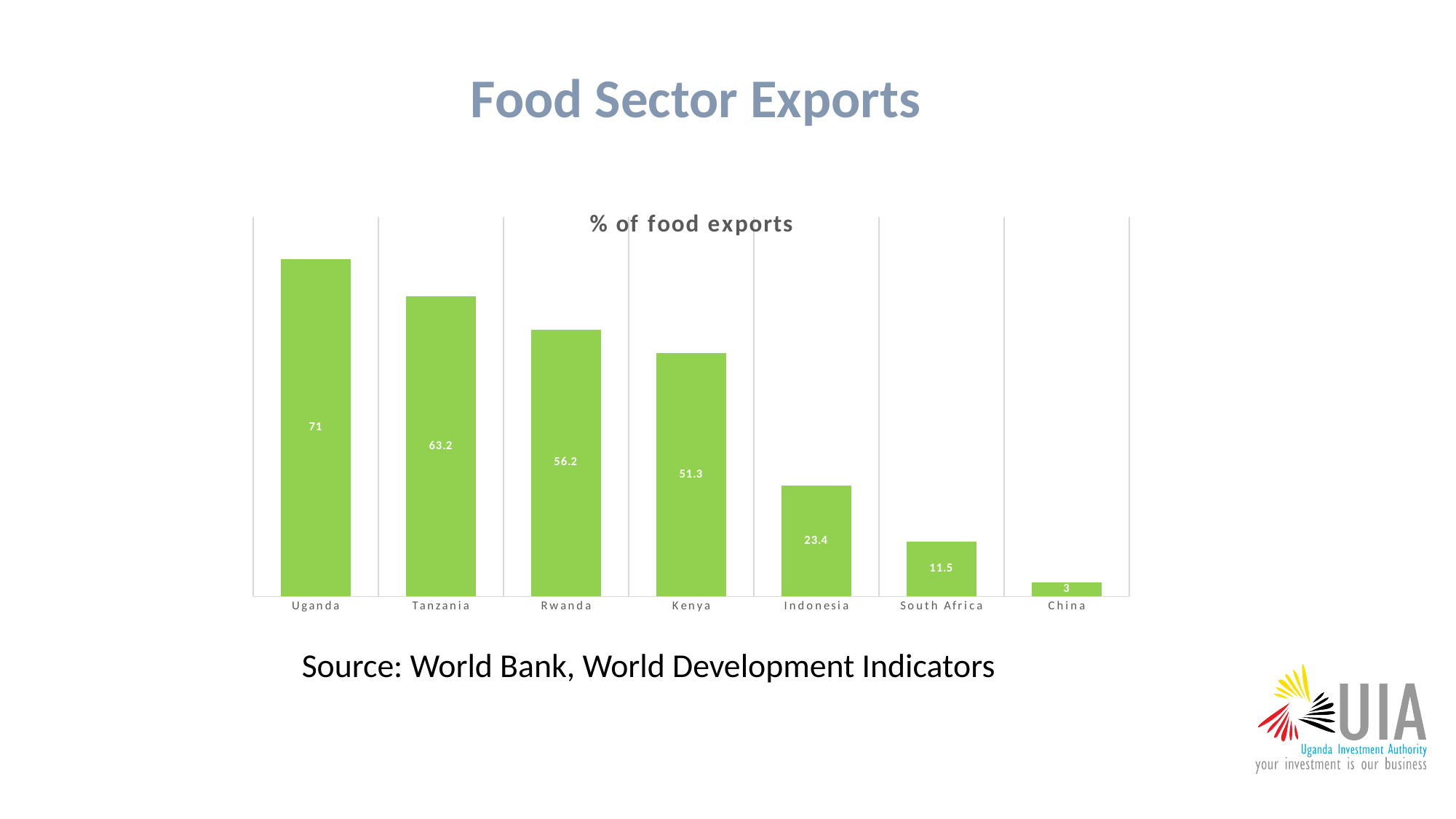
What kind of chart is shown on the slide? Bar chart Do the values rise or fall from left to right across the countries? Fall What is the difference between the values for Indonesia and China? 20.4 What is the value for South Africa? 11.5 Which country has the lowest value? China What is the value for Kenya? 51.3 Which country has the highest value? Uganda What is the difference between the values for Uganda and Tanzania? 7.8 Which is larger, the value for Rwanda or the value for Kenya? Rwanda What is the title of the chart? % of food exports How many countries are shown on the chart? 7 What is the value for Uganda? 71